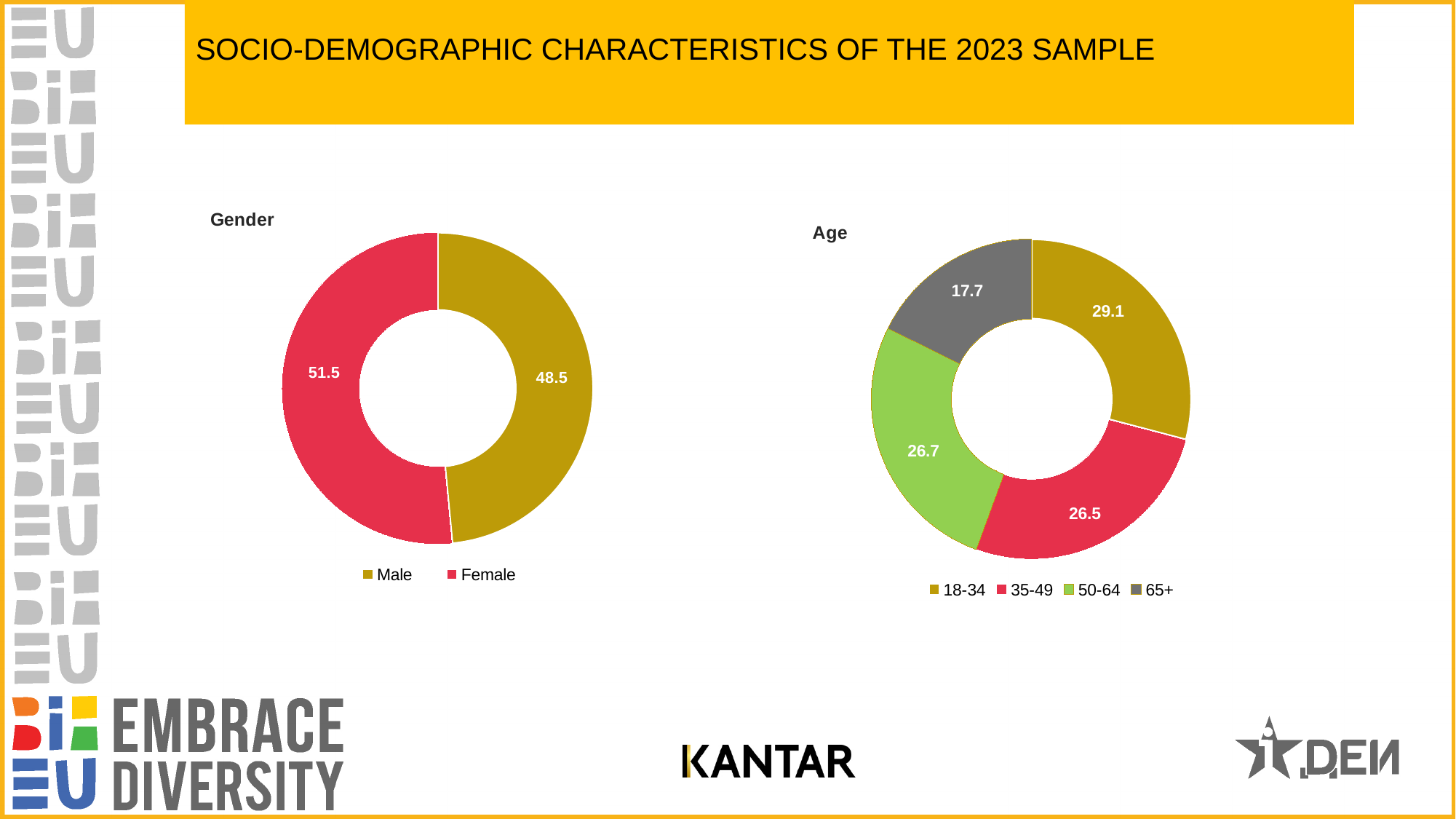
In the Age chart, what is the difference between the 18-34 and 65+ values? 11.4 In the Gender chart, what is the value for Female? 51.5 In the Gender chart, which category is larger, Male or Female? Female In the Age chart, which age group has the smallest share? 65+ In the Age chart, which age group has the largest share? 18-34 In the Age chart, what is the value for the 18-34 group? 29.1 In the Age chart, what is the value for the 65+ group? 17.7 What kind of chart is the Gender chart? Donut (pie) chart In the Age chart, what is the value for the 35-49 group? 26.5 How many age groups does the Age chart's legend list? 4 In the Gender chart, what is the value for Male? 48.5 In the Gender chart, what is the difference between the Female and Male values? 3.0